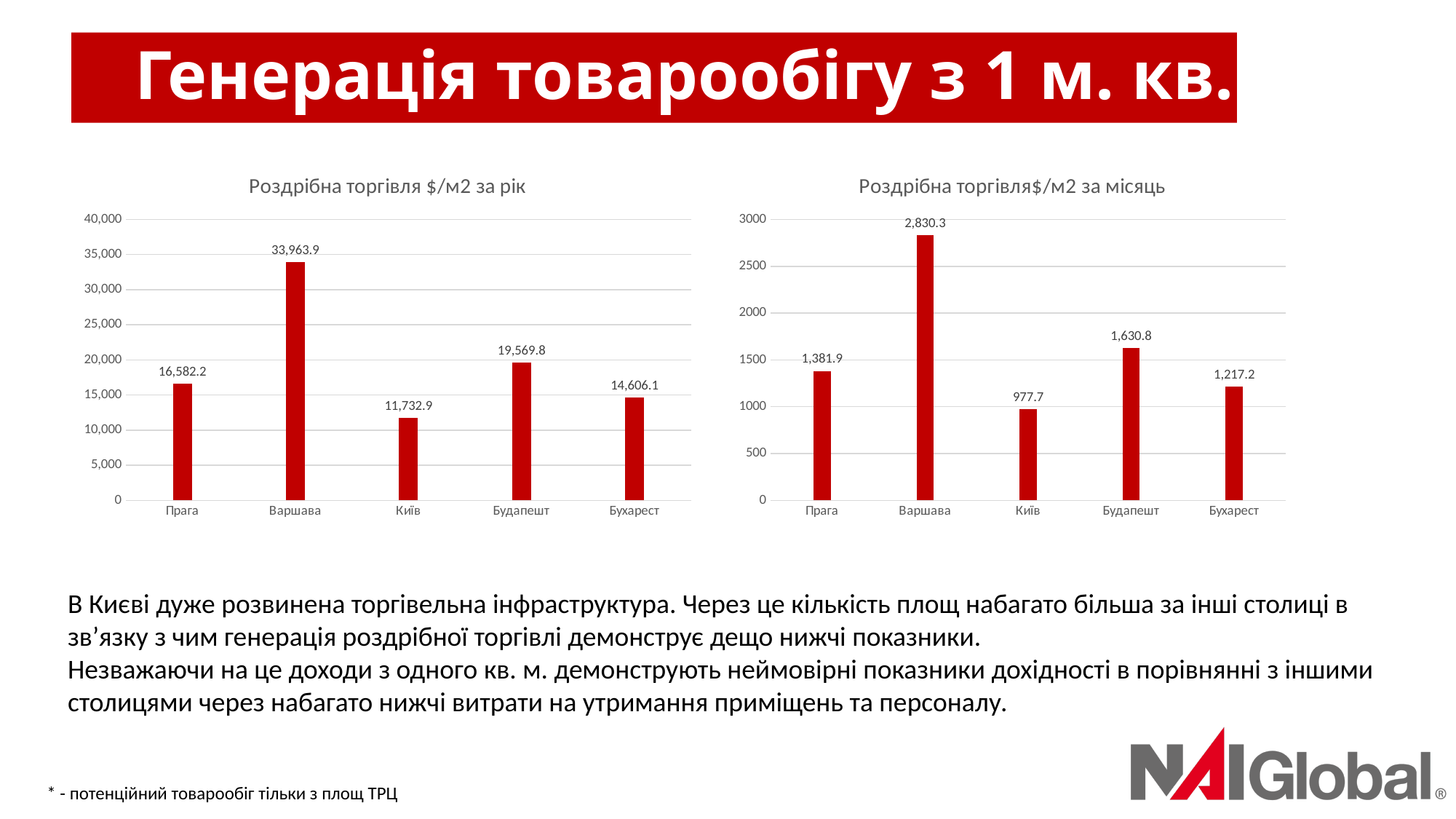
In the chart titled "Роздрібна торгівля $/м2 за рік", what is the difference between the values for Варшава and Київ? 22,231.0 What type of chart is the chart on the right of the slide? Bar chart In the chart titled "Роздрібна торгівля $/м2 за рік", what is the value for Київ? 11,732.9 In the chart titled "Роздрібна торгівля $/м2 за рік", which city has the highest value? Варшава In the chart titled "Роздрібна торгівля$/м2 за місяць", is the value for Прага greater or less than 1500? less In the chart titled "Роздрібна торгівля$/м2 за місяць", what is the difference between the values for Будапешт and Бухарест? 413.6 In the chart titled "Роздрібна торгівля $/м2 за рік", which is larger, the value for Прага or the value for Бухарест? Прага In the chart titled "Роздрібна торгівля $/м2 за рік", what is the value for Варшава? 33,963.9 In the chart titled "Роздрібна торгівля$/м2 за місяць", which city has the lowest value? Київ How many cities are shown in the chart titled "Роздрібна торгівля $/м2 за рік"? 5 In the chart titled "Роздрібна торгівля$/м2 за місяць", what is the value for Бухарест? 1,217.2 In the chart titled "Роздрібна торгівля$/м2 за місяць", what is the value for Будапешт? 1,630.8